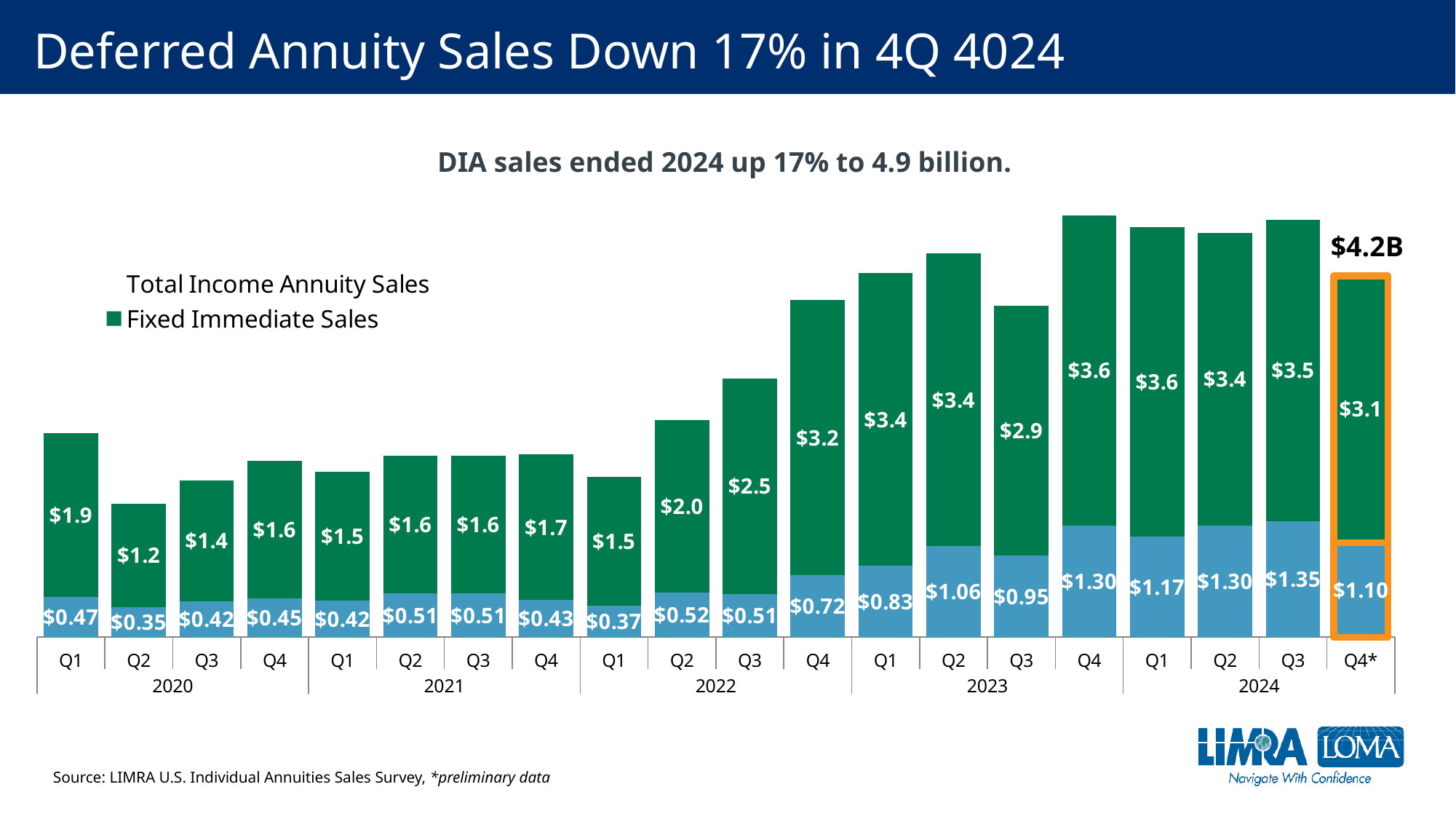
In which quarter is the blue (lower) segment highest? Q3 2024 What is the Fixed Immediate Sales value for Q4* 2024? $3.1 What is the value of the blue (lower) segment for Q3 2024? $1.35 How many quarterly bars are shown in the chart? 20 Do the Fixed Immediate Sales values rise or fall from Q1 2022 to Q4 2022? Rise What is the Fixed Immediate Sales value for Q1 2020? $1.9 What kind of chart is shown on the slide? Stacked bar chart Which is larger, the Fixed Immediate Sales value for Q3 2023 or for Q4 2023? Q4 2023 What is the value of the blue (lower) segment for Q4 2022? $0.72 In which quarter is the Fixed Immediate Sales value lowest? Q2 2020 What is the difference between the Fixed Immediate Sales values for Q3 2024 and Q4* 2024? $0.4 What total is labeled above the highlighted Q4* 2024 bar? $4.2B